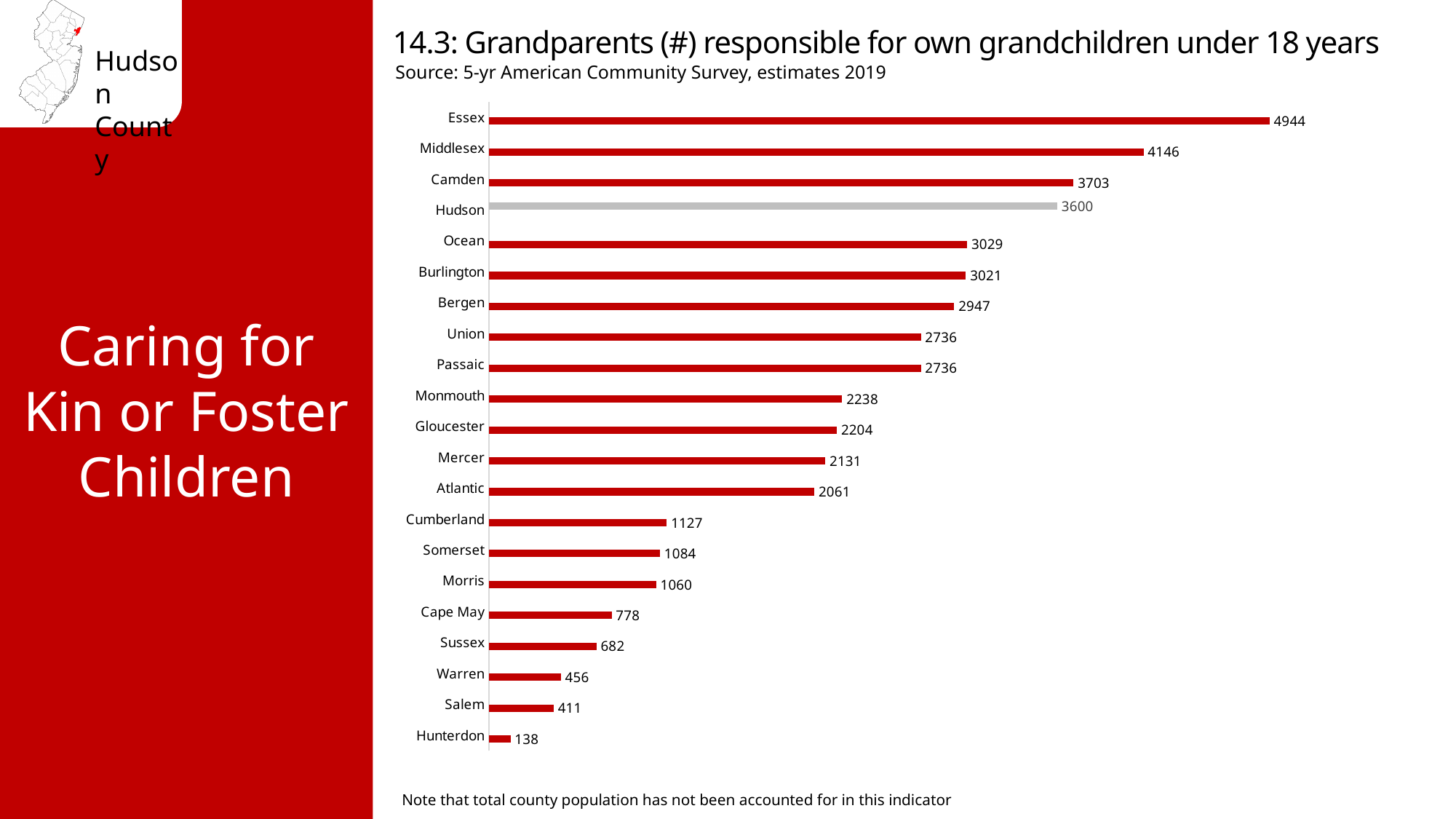
What is the value for Cape May? 778 Which county's bar is shown in grey rather than red? Hudson Which is larger, the value for Sussex or the value for Warren? Sussex Which county has the lowest value? Hunterdon What is the value for Hudson? 3600 What is the difference between the values for Camden and Hudson? 103 What is the difference between the values for Essex and Middlesex? 798 How many counties are shown in the chart? 21 Which is larger, the value for Monmouth or the value for Atlantic? Monmouth What kind of chart is shown on the slide? Bar chart Which county has the highest number of grandparents responsible for own grandchildren? Essex What is the value for Essex? 4944